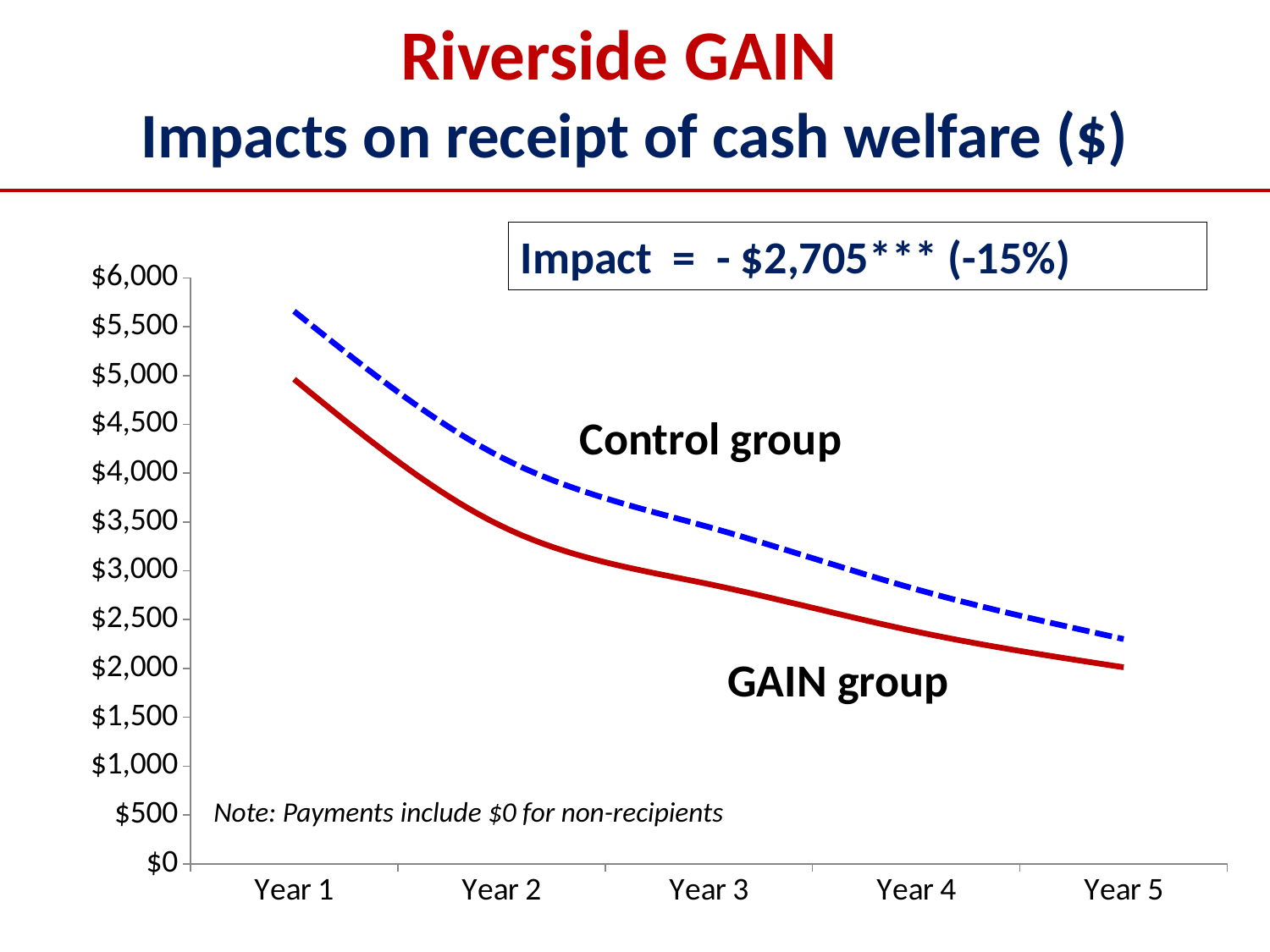
Does the GAIN group line rise or fall from Year 1 to Year 5? Fall What kind of chart is shown on the slide? Line chart In Year 1, which group has the higher cash welfare receipt, the Control group or the GAIN group? Control group Is the GAIN group's value in Year 5 greater or less than $2,500? less Does the Control group line rise or fall from Year 1 to Year 5? Fall How many years are shown along the x axis? 5 In which year is the Control group's cash welfare receipt highest? Year 1 What impact value is stated in the box on the chart? - $2,705*** (-15%) In Year 5, which group has the lower cash welfare receipt, the Control group or the GAIN group? GAIN group How many series (groups) are plotted on the chart? 2 Is the Control group's value in Year 1 greater or less than $5,000? greater In which year is the GAIN group's cash welfare receipt lowest? Year 5